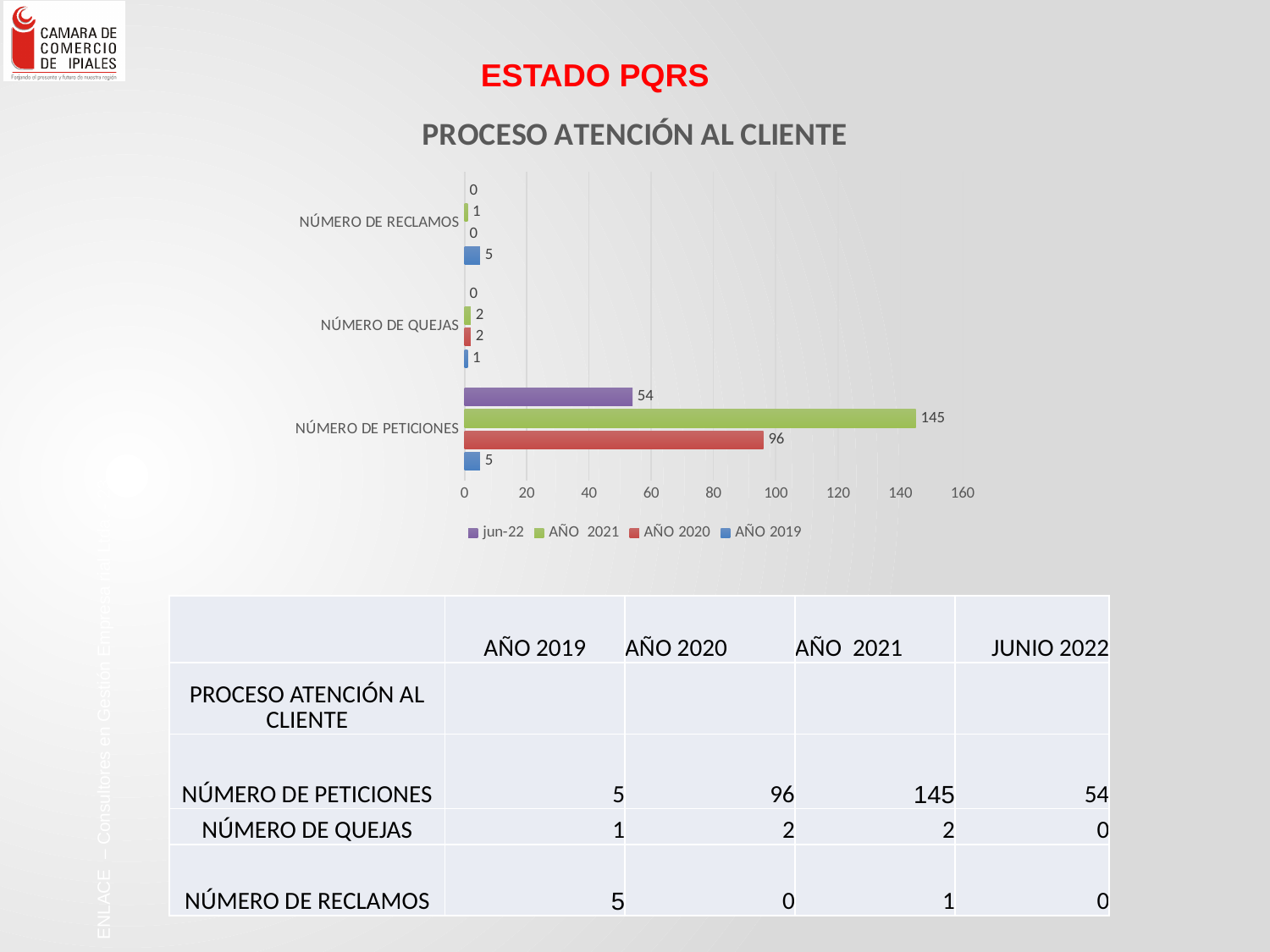
How many series does the legend list? 4 What is the difference between the AÑO 2021 and AÑO 2020 values for NÚMERO DE PETICIONES? 49 What is the value for NÚMERO DE PETICIONES in the AÑO 2020 series? 96 How many categories are shown on the chart? 3 Which series has the lowest value for NÚMERO DE PETICIONES? AÑO 2019 What is the value for NÚMERO DE PETICIONES in the AÑO 2021 series? 145 Which series has the highest value for NÚMERO DE PETICIONES? AÑO 2021 What is the title of the chart? PROCESO ATENCIÓN AL CLIENTE What type of chart is shown on the slide? Bar chart For NÚMERO DE PETICIONES, which is larger: the jun-22 value or the AÑO 2020 value? AÑO 2020 What is the value for NÚMERO DE QUEJAS in the jun-22 series? 0 What is the value for NÚMERO DE RECLAMOS in the AÑO 2019 series? 5